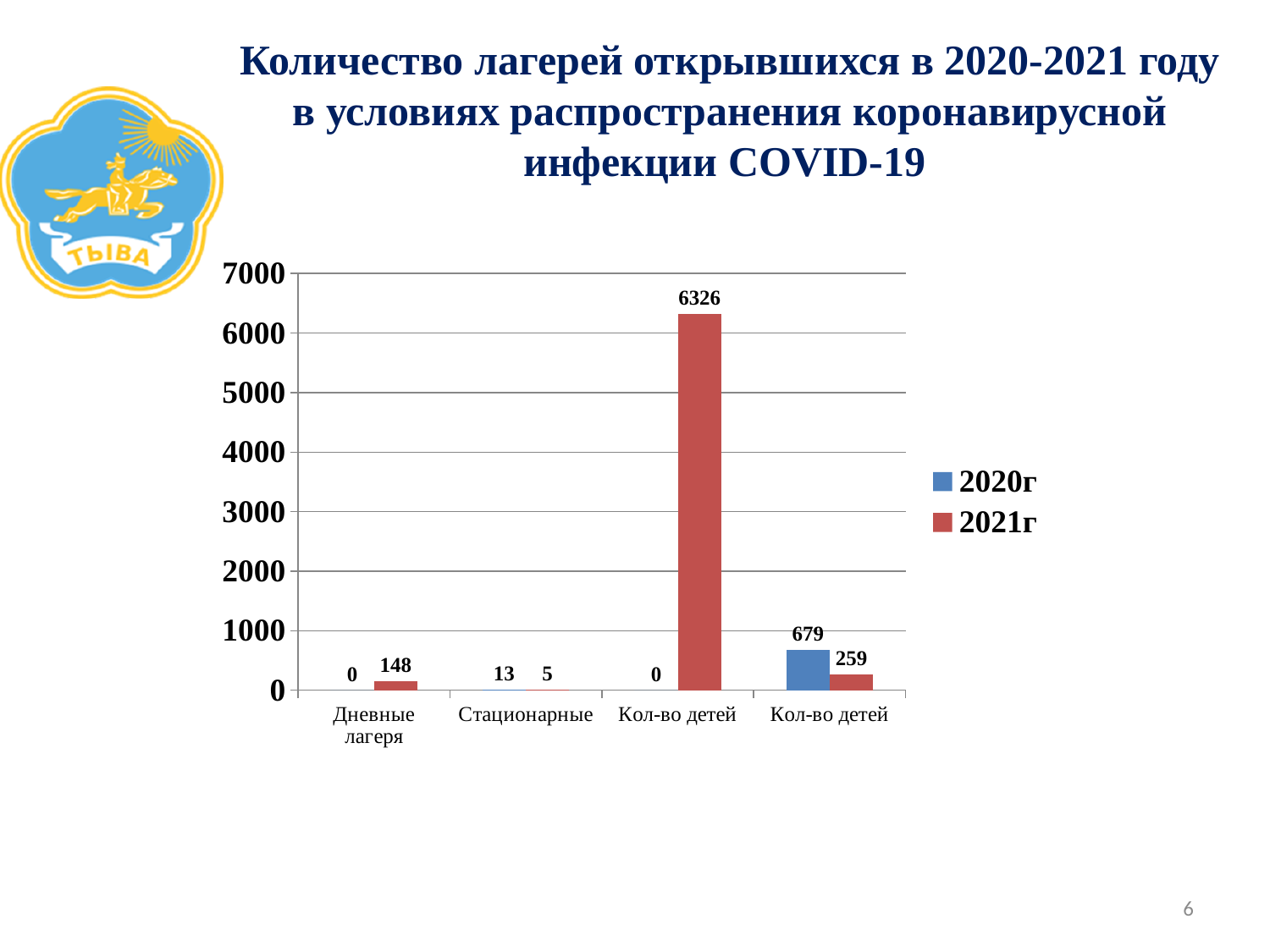
What is the 2021г value for the third category (Кол-во детей)? 6326 For the fourth category (the second Кол-во детей), which is larger: the 2020г value or the 2021г value? 2020г What is the value for 2020г for Дневные лагеря? 0 How many series does the legend list? 2 What type of chart is shown on the slide? bar chart Which bar has the highest value in the chart? 2021г for the third category (Кол-во детей), 6326 What is the value for 2021г for Дневные лагеря? 148 What is the value for 2021г for Стационарные? 5 What is the value for 2020г for Стационарные? 13 How many categories are shown on the x axis? 4 What is the difference between the 2020г and 2021г values for Стационарные? 8 What is the 2020г value for the fourth category (the second Кол-во детей)? 679